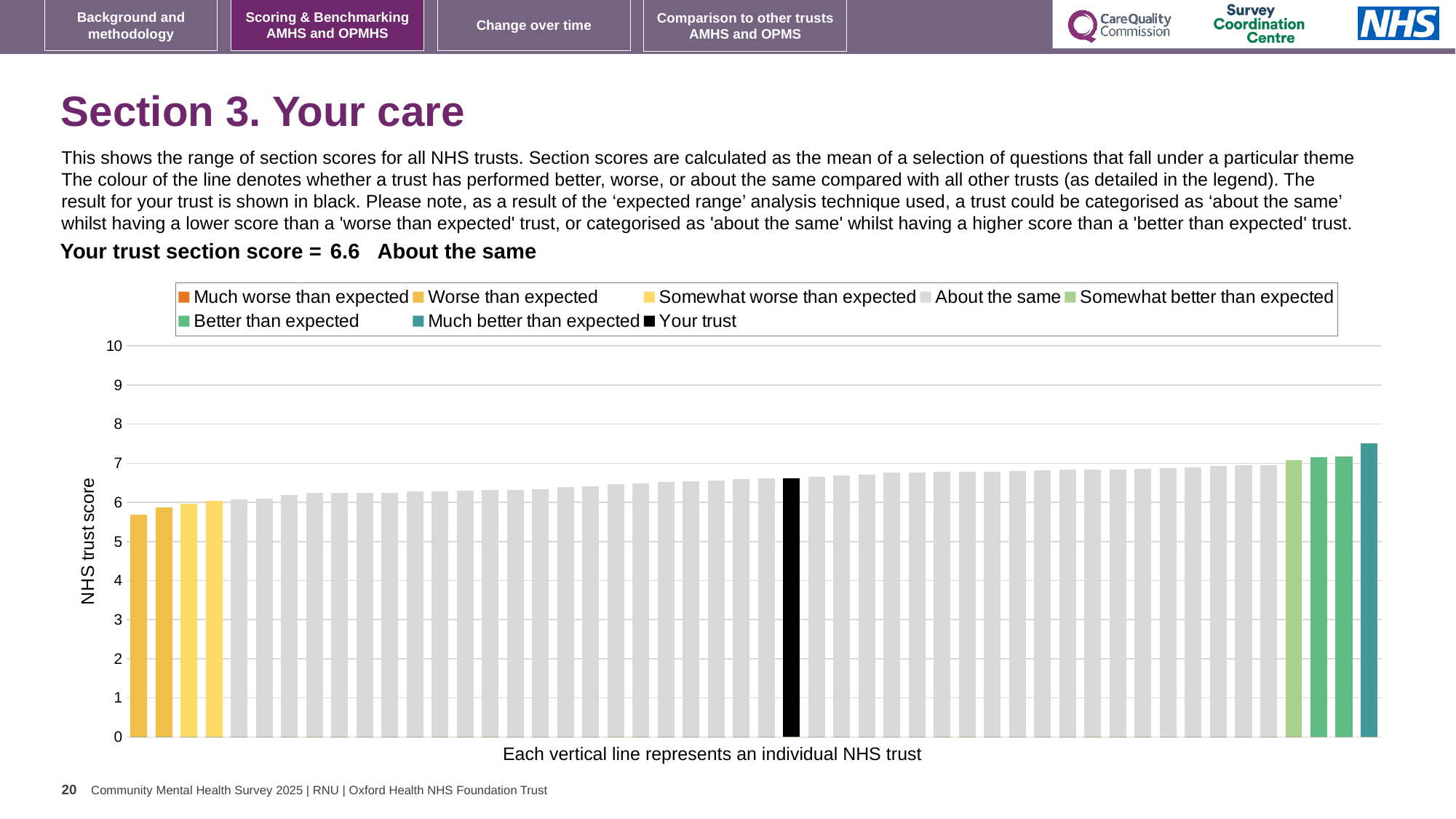
Is the value of the highest bar on the chart greater or less than 8? less Do the bar values rise or fall from left to right along the x axis? rise What colour is the bar representing your trust? black Is the value of the highest bar on the chart greater or less than 7? greater What kind of chart is shown on the slide? bar chart How many entries does the chart legend list? 8 Is the value of the lowest bar on the chart greater or less than 6? less Which category is your trust placed in for this section? About the same What is the title of the vertical axis? NHS trust score What is the section score for your trust shown on the slide? 6.6 How many bars are coloured as 'Much better than expected'? 1